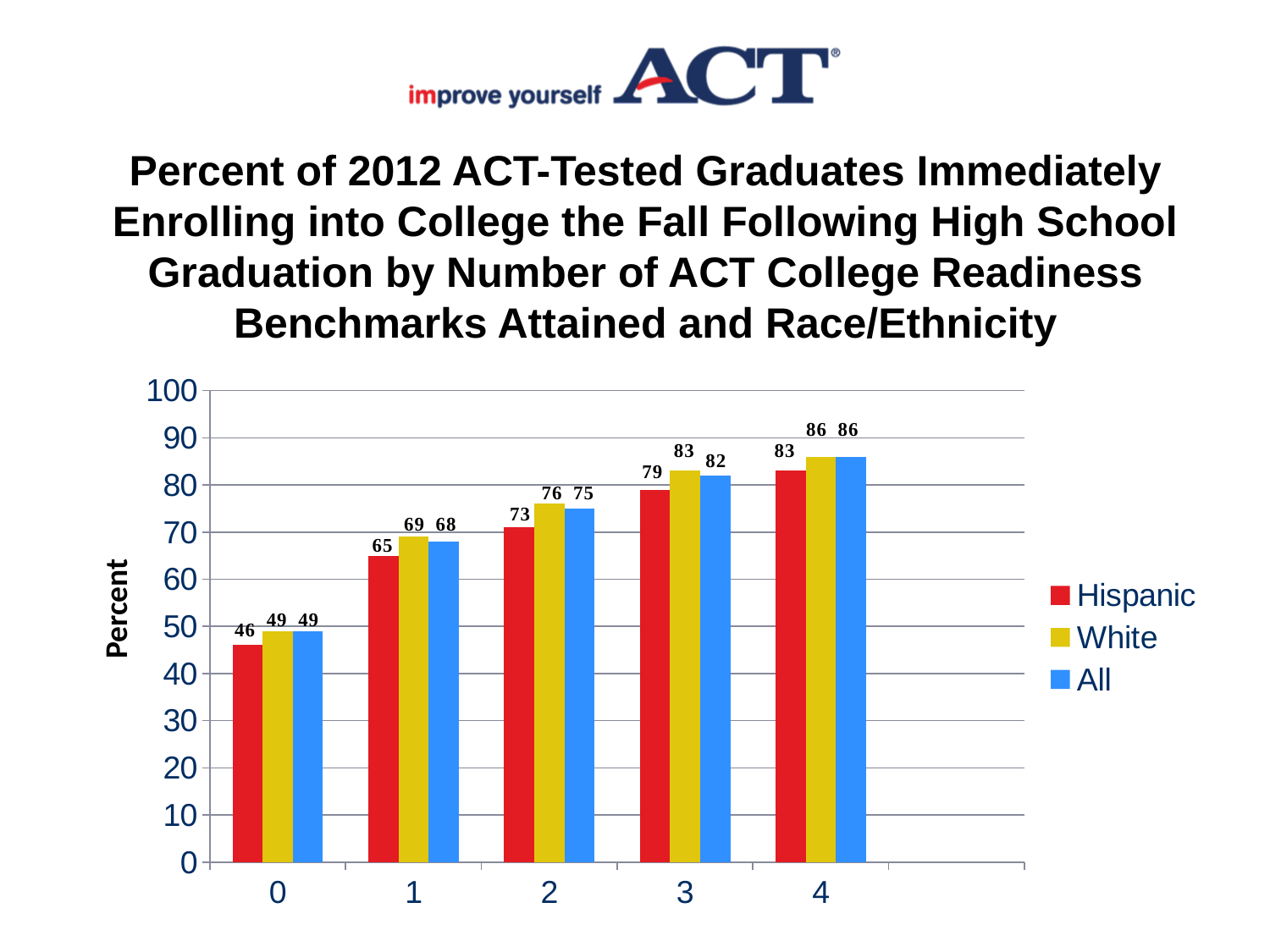
What is the difference between the White and Hispanic values at 1 benchmark attained? 4 At which number of benchmarks attained is the Hispanic value highest? 4 How many series does the legend list? 3 What kind of chart is shown on the slide? bar chart What is the value for All at 3 benchmarks attained? 82 At which number of benchmarks attained is the All value lowest? 0 Do the White values rise or fall as the number of benchmarks attained increases from 0 to 4? rise Is the value for Hispanic at 2 benchmarks attained greater or less than 70? greater What is the value for Hispanic at 0 benchmarks attained? 46 Which is larger at 3 benchmarks attained, the Hispanic value or the White value? White What is the value for White at 2 benchmarks attained? 76 How many categories are shown on the x axis? 5